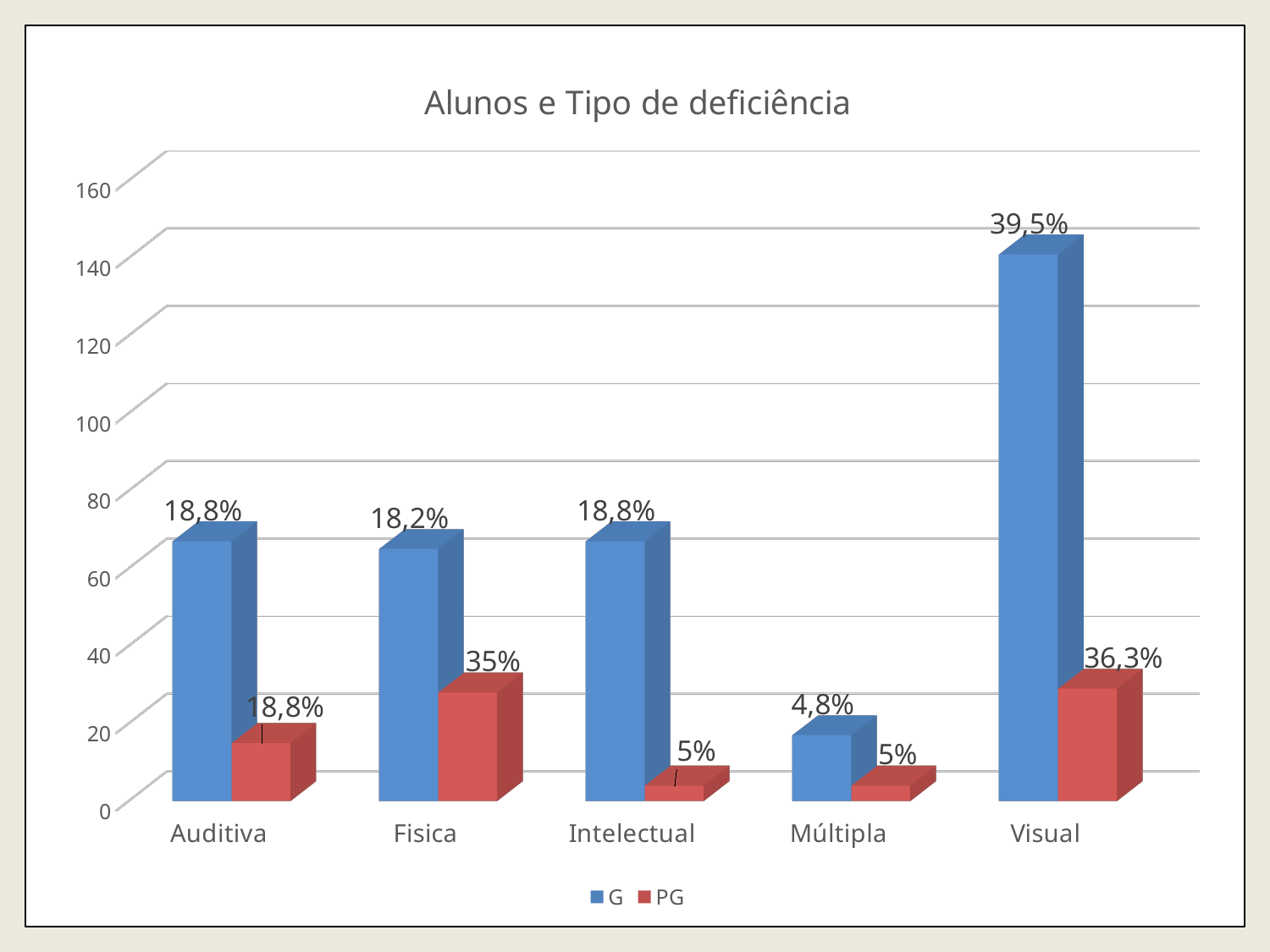
What is the difference between the G data labels for Visual (39,5%) and Múltipla (4,8%)? 34,7% How many categories are shown on the x axis? 5 Which category has the highest value for the G series? Visual Which category has the highest value for the PG series? Visual Is the G bar for Visual greater or less than 100 on the vertical axis? greater Which category has the lowest value for the G series? Múltipla How many series does the legend list? 2 What is the data label shown for the G series in the Múltipla category? 4,8% What is the data label shown for the G series in the Visual category? 39,5% Which is larger for the PG series: Auditiva or Intelectual? Auditiva What is the data label shown for the PG series in the Fisica category? 35% What is the data label shown for the PG series in the Intelectual category? 5%